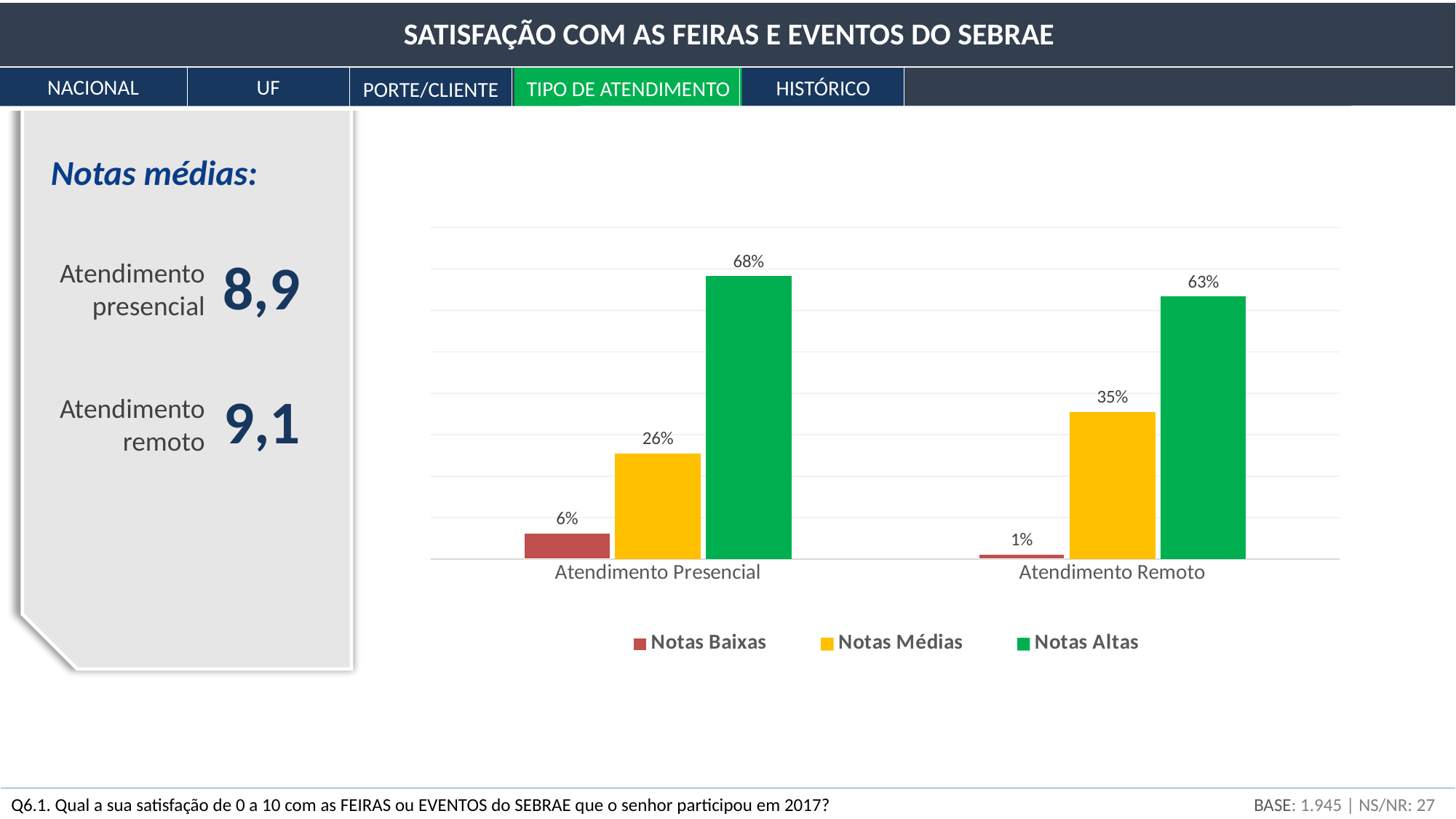
What is the value for Notas Médias in the Atendimento Remoto category? 35% Which series has the highest value in the Atendimento Remoto category? Notas Altas What is the difference between Notas Altas for Atendimento Presencial and Notas Altas for Atendimento Remoto? 5% How many series does the chart legend list? 3 What kind of chart is shown on the slide? Bar chart Which series has the lowest value in the Atendimento Presencial category? Notas Baixas What is the value for Notas Baixas in the Atendimento Remoto category? 1% What is the value for Notas Altas in the Atendimento Presencial category? 68% What is the value for Notas Baixas in the Atendimento Presencial category? 6% Which is larger: Notas Médias for Atendimento Presencial or Notas Médias for Atendimento Remoto? Notas Médias for Atendimento Remoto How many categories are shown on the x axis of the chart? 2 What colour represents the Notas Altas series in the chart? Green